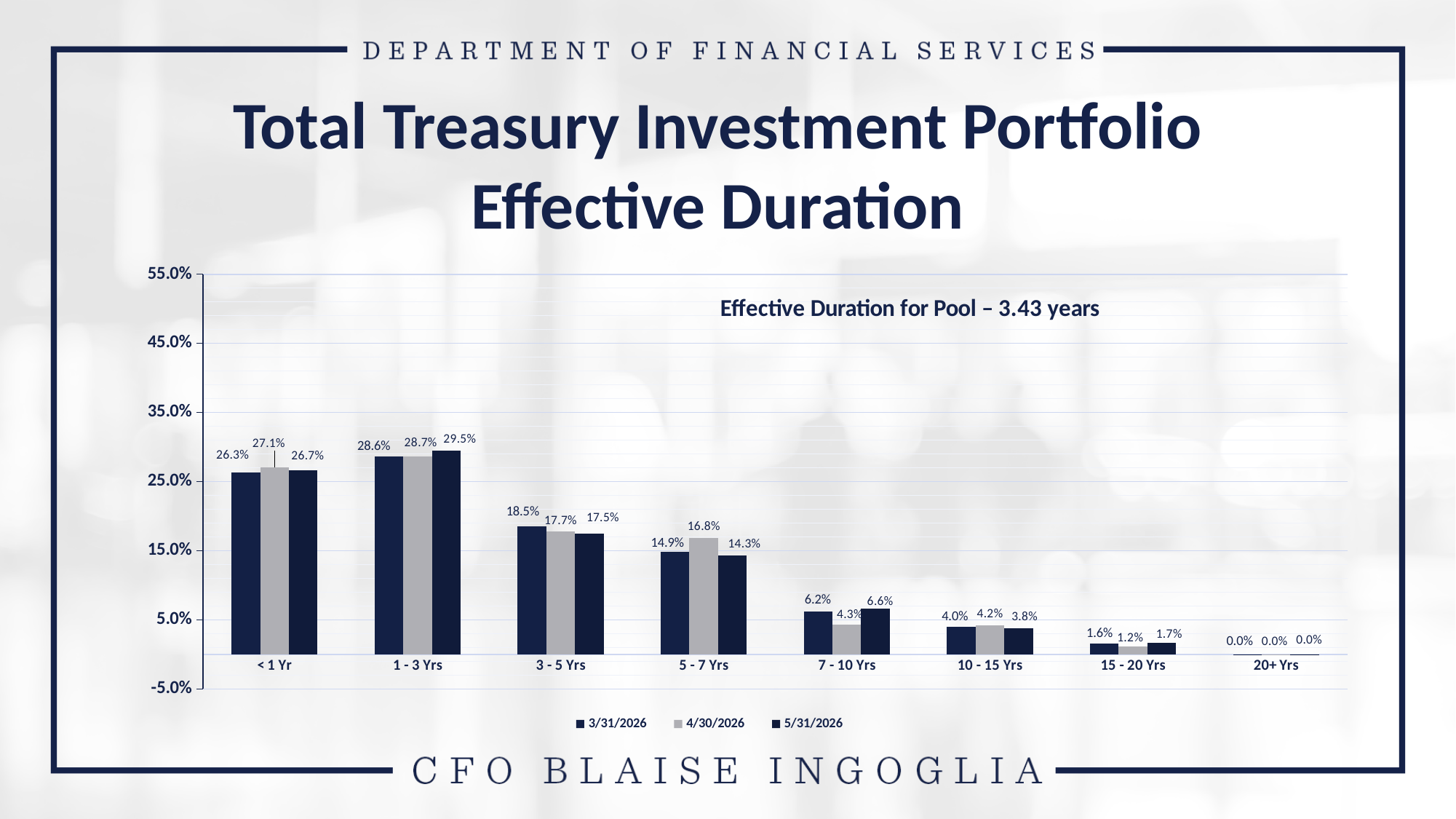
How many maturity categories are shown on the x axis? 8 How many series does the legend list? 3 What kind of chart is shown on the slide? Bar chart What effective duration for the pool is stated on the chart? 3.43 years Which category has the highest value in the 5/31/2026 series? 1 - 3 Yrs What is the value for 7 - 10 Yrs in the 3/31/2026 series? 6.2% What is the value for 1 - 3 Yrs in the 5/31/2026 series? 29.5% Do the 5/31/2026 values rise or fall from 1 - 3 Yrs to 20+ Yrs along the x axis? Fall Which category has the lowest value in the 3/31/2026 series? 20+ Yrs What is the difference between the 3/31/2026 and 5/31/2026 values for 3 - 5 Yrs? 1.0% For 7 - 10 Yrs, which is larger: the 4/30/2026 value or the 5/31/2026 value? 5/31/2026 What is the value for 5 - 7 Yrs in the 4/30/2026 series? 16.8%